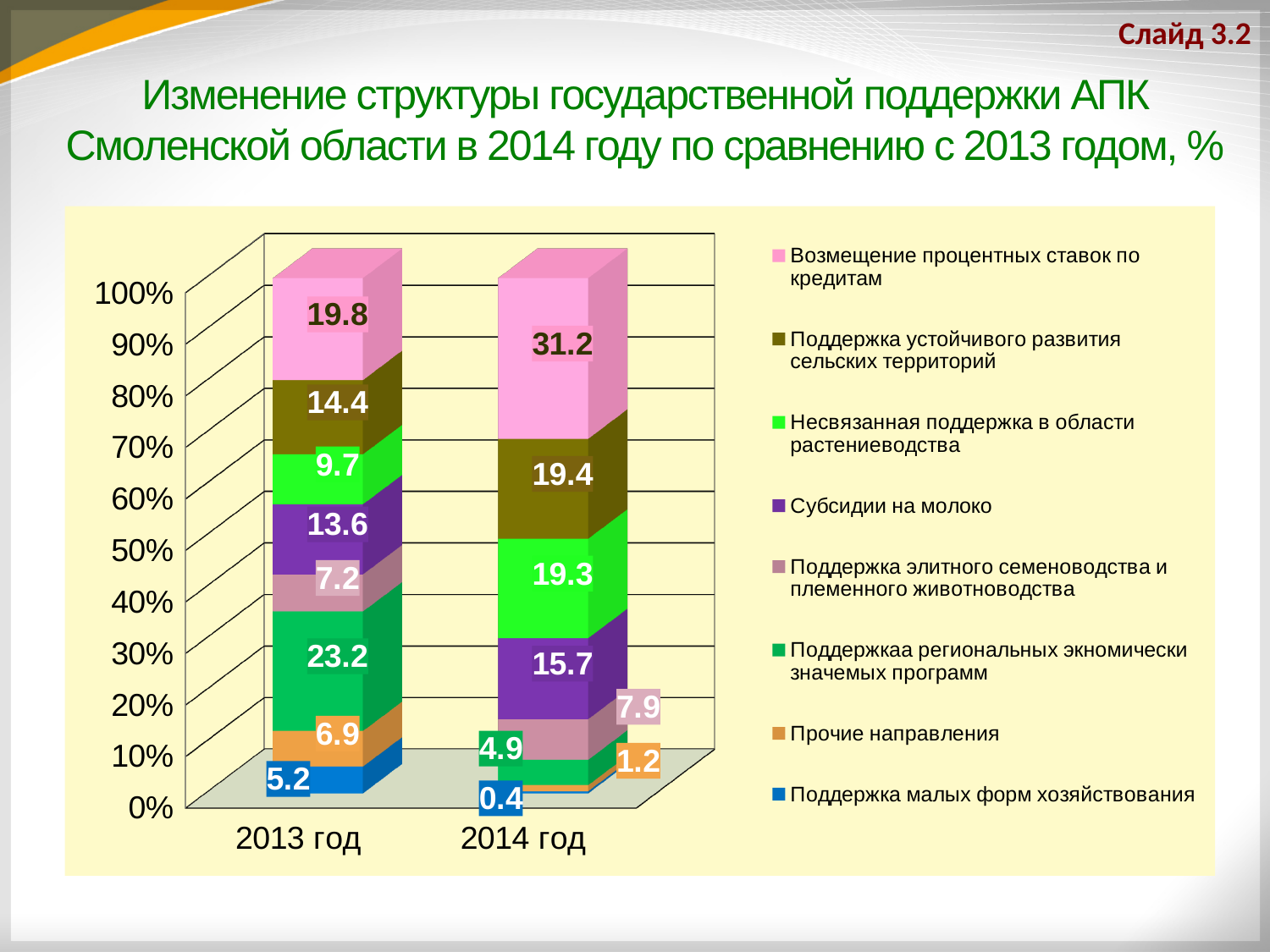
What is the value for 'Возмещение процентных ставок по кредитам' in 2014 год? 31.2 What is the value for 'Поддержка региональных экономически значимых программ' in 2013 год? 23.2 Which series has the largest share in 2014 год? Возмещение процентных ставок по кредитам Which series has the smallest share in 2013 год? Поддержка малых форм хозяйствования By how much did the value for 'Возмещение процентных ставок по кредитам' change from 2013 год to 2014 год? 11.4 What is the value for 'Субсидии на молоко' in 2013 год? 13.6 What type of chart is shown on the slide? stacked bar chart How many series does the legend list? 8 Did the value for 'Прочие направления' rise or fall from 2013 год to 2014 год? fall How many categories (years) are shown on the x axis? 2 What is the value for 'Поддержка малых форм хозяйствования' in 2014 год? 0.4 Which is larger: 'Несвязанная поддержка в области растениеводства' in 2013 год or in 2014 год? 2014 год